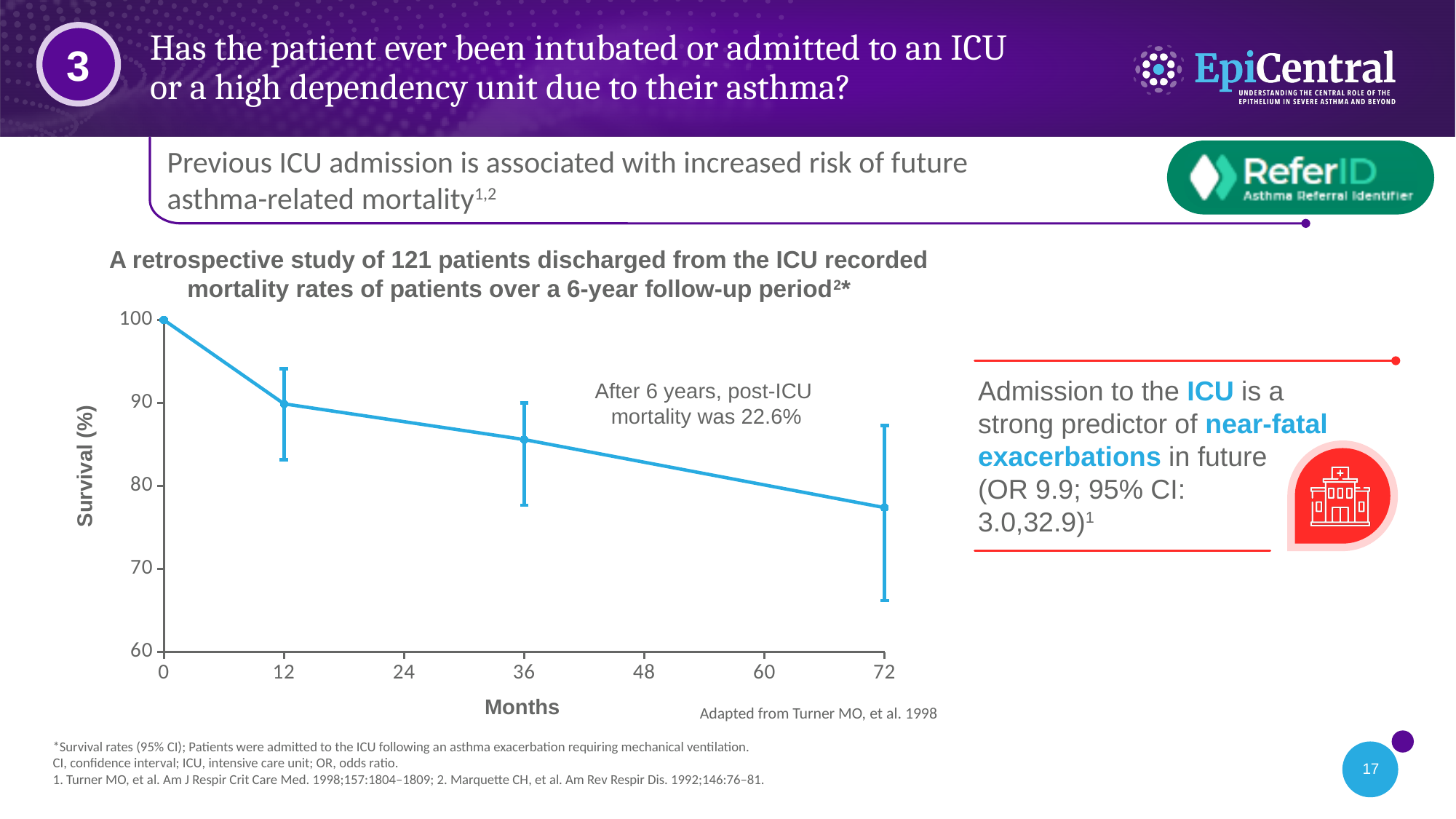
At which month is survival (%) highest? 0 According to the annotation on the chart, what was post-ICU mortality after 6 years? 22.6% Do the survival values rise or fall as months increase along the x axis? fall Is the survival value at 72 months greater or less than 80? less What is the survival (%) value at 0 months? 100 What is the label of the y axis? Survival (%) How many data points are plotted on the survival line? 4 What kind of chart is shown on the slide? line chart Is the survival value at 12 months greater or less than 80? greater Is the survival value at 36 months greater or less than 90? less At which month is survival (%) lowest? 72 Which is larger, the survival value at 12 months or at 72 months? 12 months